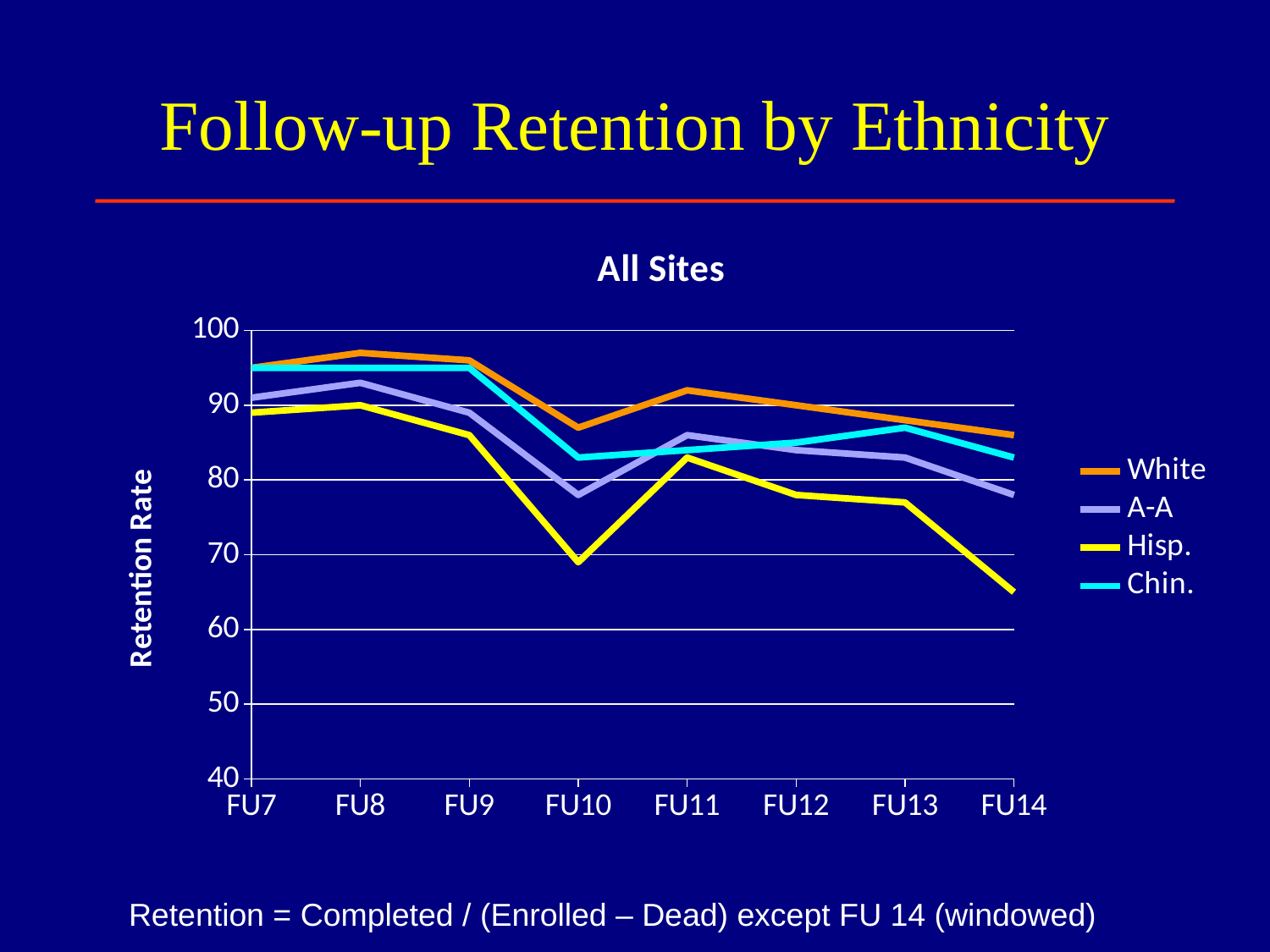
Does the Hisp. retention rate rise or fall overall from FU7 to FU14? fall What is the label on the y axis of the chart? Retention Rate Is the retention rate for Hisp. at FU14 greater or less than 70? less Is the retention rate for White at FU8 greater or less than 90? greater How many series does the legend list? 4 Which series has the highest retention rate at FU14? White Is the retention rate for Chin. at FU10 greater or less than 90? less What kind of chart is shown on the slide? line chart At FU10, which series has the larger retention rate, White or Hisp.? White How many follow-up points are shown along the x axis? 8 Which series has the lowest retention rate at FU14? Hisp.